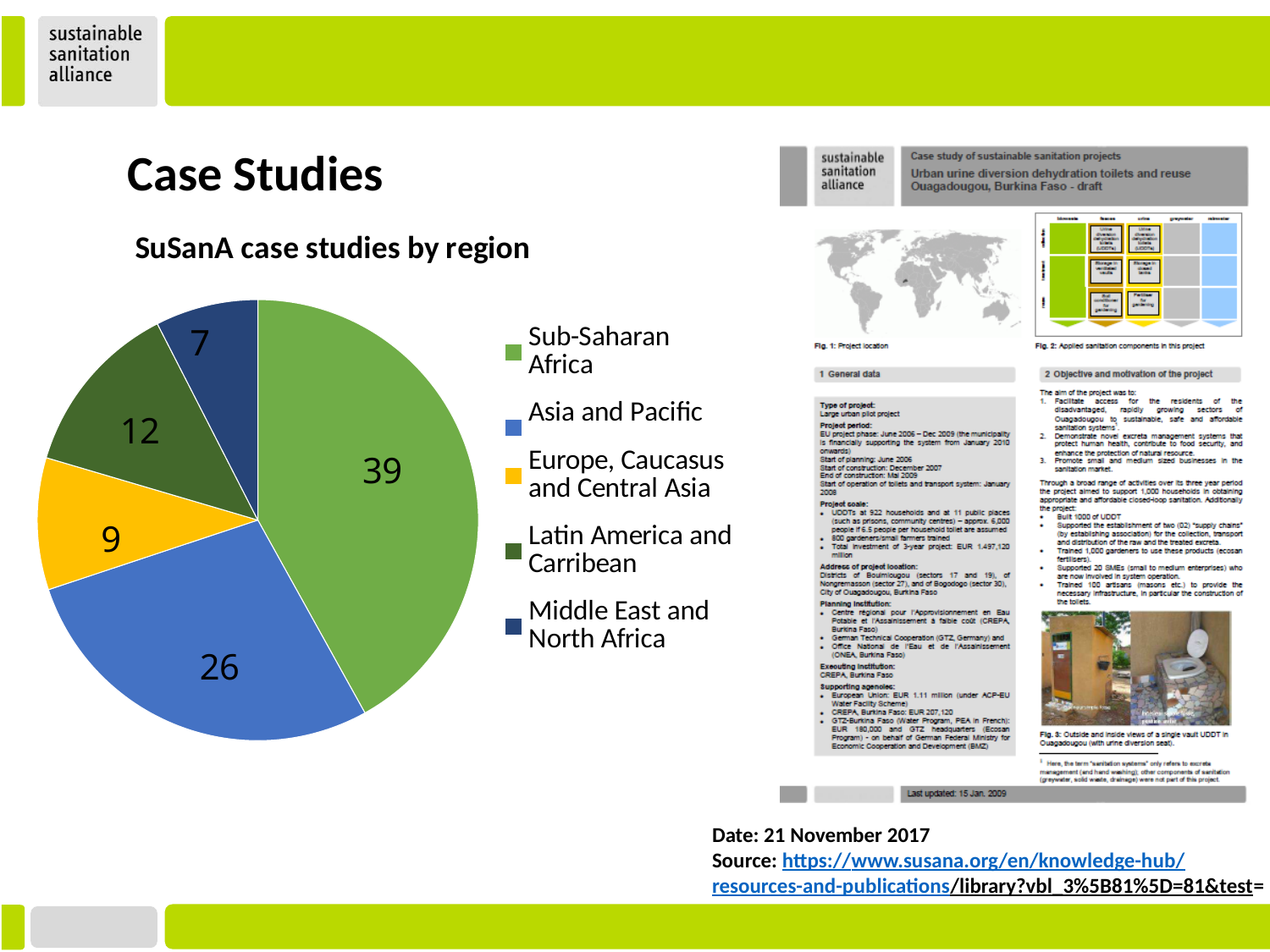
How many case studies are from Latin America and Carribean? 12 What is the total number of case studies across all regions in the pie chart? 93 What kind of chart is shown on the slide? Pie chart How many regions are shown in the pie chart? 5 Which region has the smallest number of case studies? Middle East and North Africa How many case studies are from Asia and Pacific? 26 How many case studies are from Middle East and North Africa? 7 How many case studies are from Sub-Saharan Africa? 39 What is the difference between the number of case studies in Sub-Saharan Africa and in Asia and Pacific? 13 Which has more case studies: Europe, Caucasus and Central Asia or Latin America and Carribean? Latin America and Carribean What is the title of the chart? SuSanA case studies by region Which region has the largest number of case studies? Sub-Saharan Africa